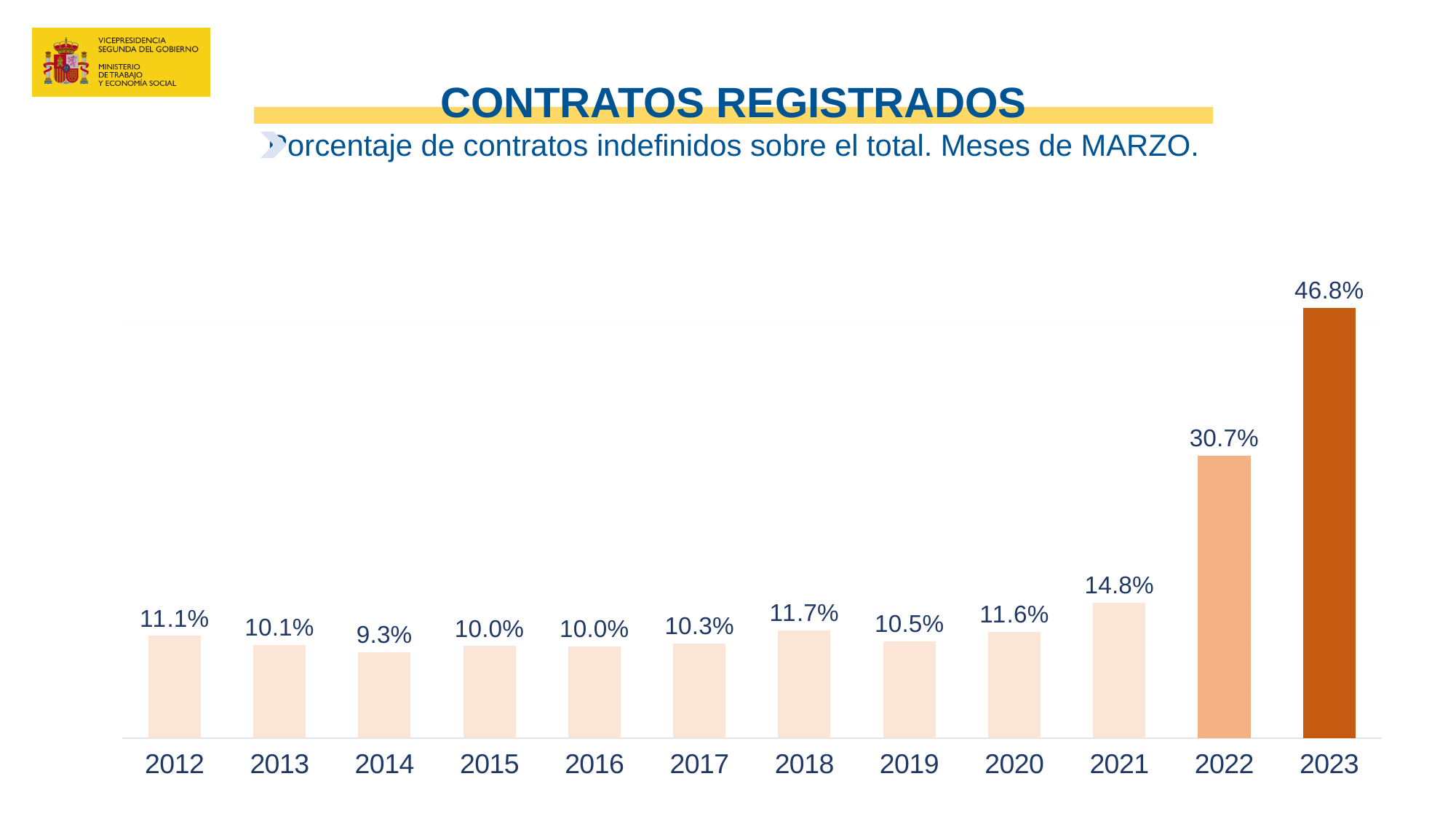
Which is larger, the value for 2019 or the value for 2020? 2020 Which year has the lowest value? 2014 What kind of chart is this? Bar chart What is the difference between the values for 2021 and 2020? 3.2% Which year's bar is drawn in the darkest colour? 2023 What is the value for 2018? 11.7% How many years are shown on the x axis? 12 What is the value for 2022? 30.7% Which year has the highest value? 2023 What is the value for 2023? 46.8% What is the value for 2014? 9.3% What is the difference between the values for 2023 and 2022? 16.1%